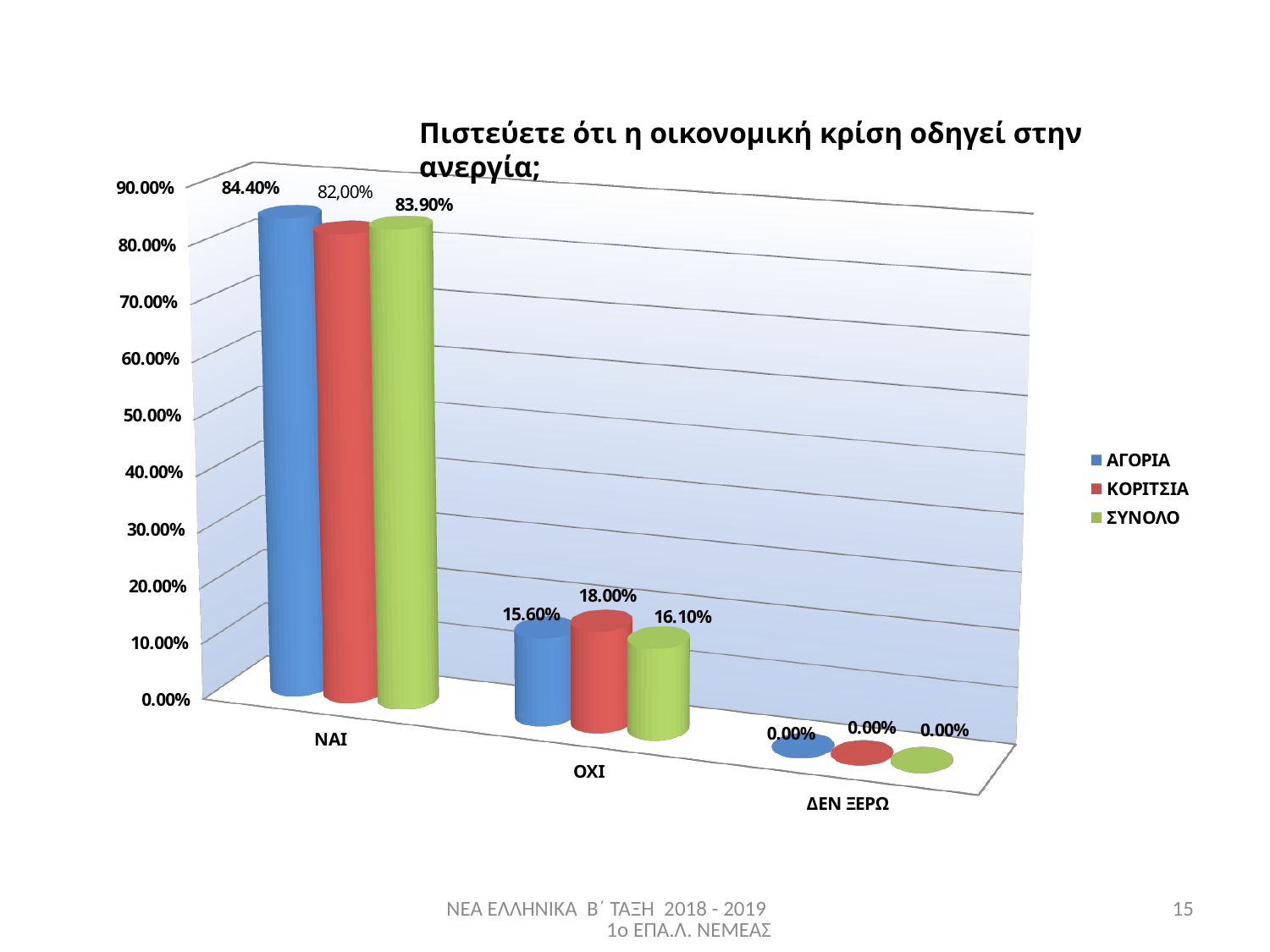
What is the value for ΑΓΟΡΙΑ in the ΔΕΝ ΞΕΡΩ category? 0.00% What is the value for ΚΟΡΙΤΣΙΑ in the ΟΧΙ category? 18.00% How many categories are shown on the x axis? 3 What is the value for ΑΓΟΡΙΑ in the ΝΑΙ category? 84.40% What is the value for ΚΟΡΙΤΣΙΑ in the ΝΑΙ category? 82,00% What is the value for ΣΥΝΟΛΟ in the ΟΧΙ category? 16.10% How many series does the legend list? 3 In the ΟΧΙ category, which series has the larger value, ΑΓΟΡΙΑ or ΚΟΡΙΤΣΙΑ? ΚΟΡΙΤΣΙΑ Which category has the lowest value for ΚΟΡΙΤΣΙΑ? ΔΕΝ ΞΕΡΩ What kind of chart is shown on the slide? Bar chart What is the difference between the ΑΓΟΡΙΑ and ΚΟΡΙΤΣΙΑ values in the ΟΧΙ category? 2.40% Which category has the highest value for ΣΥΝΟΛΟ? ΝΑΙ